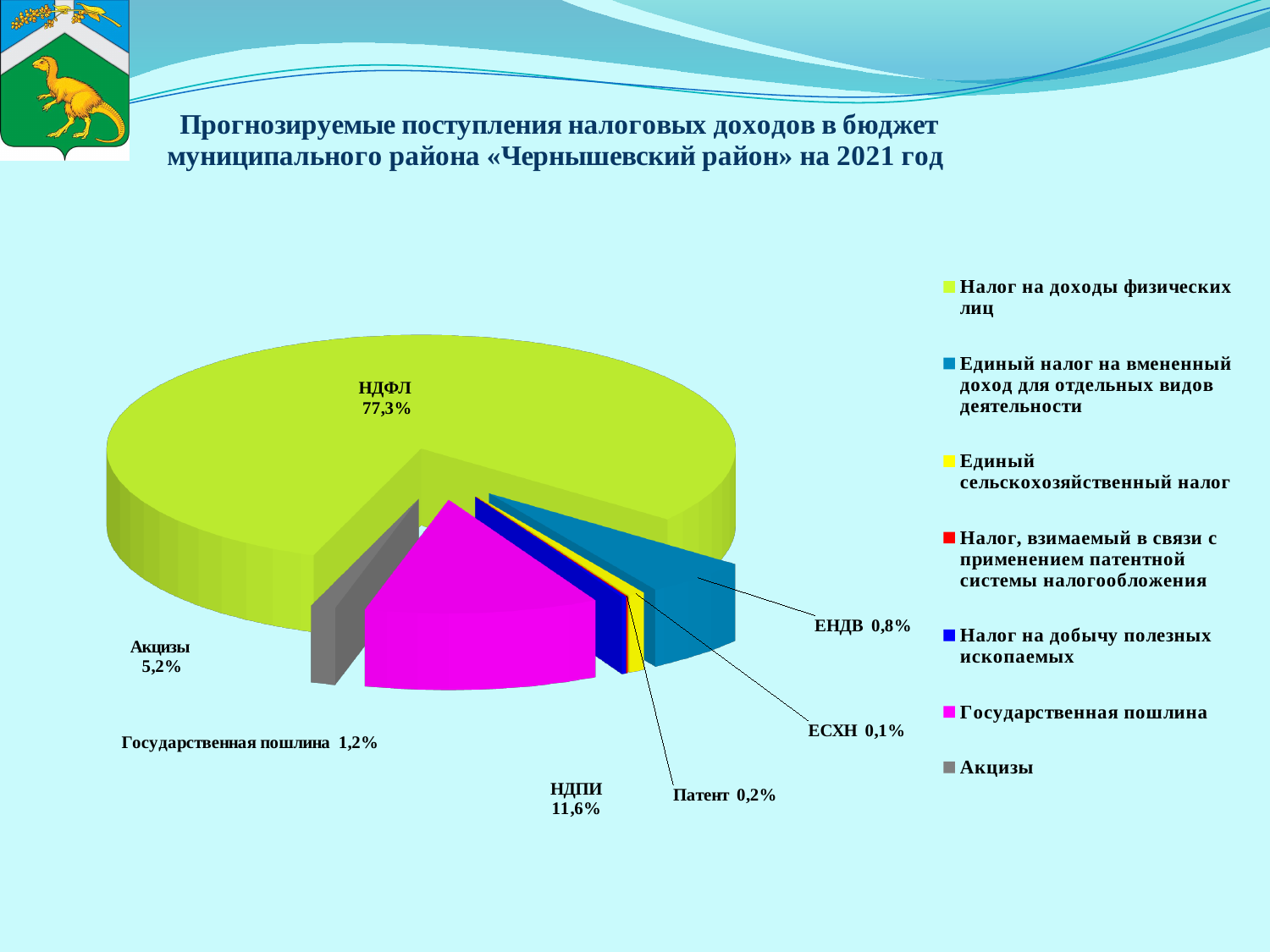
What share of the pie is labelled НДФЛ? 77,3% What share of the pie is labelled Акцизы? 5,2% Which slice is larger, Акцизы or Патент? Акцизы What kind of chart is shown on the slide? pie chart What share of the pie is labelled НДПИ? 11,6% What share of the pie is labelled ЕНДВ? 0,8% What share of the pie is labelled ЕСХН? 0,1% Which labelled slice has the smallest share of the pie? ЕСХН What share of the pie is labelled Государственная пошлина? 1,2% Which labelled slice has the largest share of the pie? НДФЛ What is the difference in percentage points between the НДФЛ slice and the НДПИ slice? 65,7 How many entries does the legend list? 7